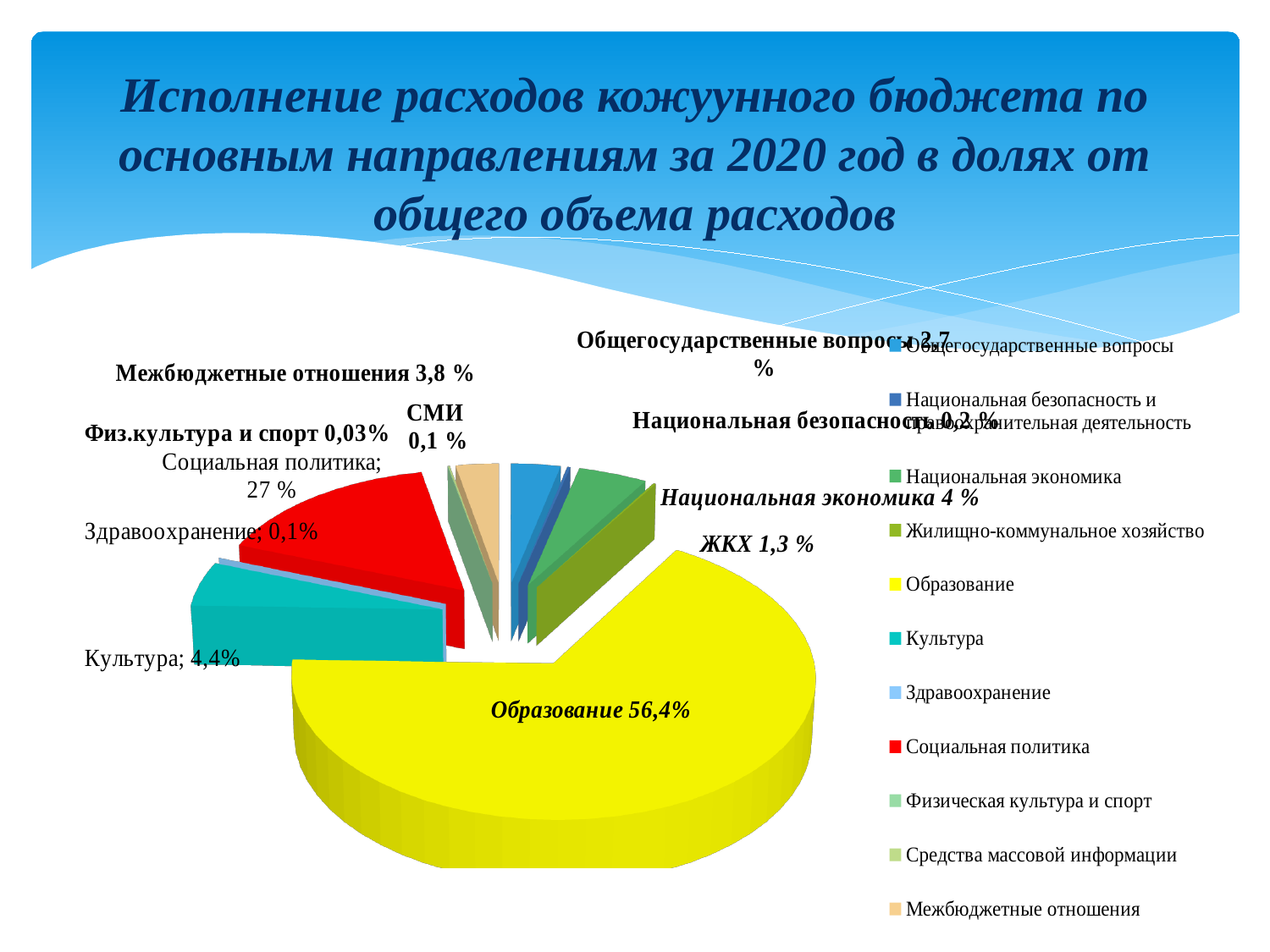
What share is shown for Культура (culture)? 4,4% How many categories does the legend list? 11 What colour is the Образование slice of the pie? Yellow What share is shown for Национальная экономика (national economy)? 4 % What share is shown for Межбюджетные отношения (inter-budget relations)? 3,8 % Which category has the largest share of expenditures? Образование Which has a larger share: Культура or Национальная экономика? Культура What type of chart is shown on the slide? Pie chart Which category has the smallest share of expenditures? Физ.культура и спорт What share is shown for Социальная политика (social policy)? 27 % By how many percentage points does the share of Образование exceed the share of Социальная политика? 29,4 What share of expenditures does Образование (education) account for? 56,4%